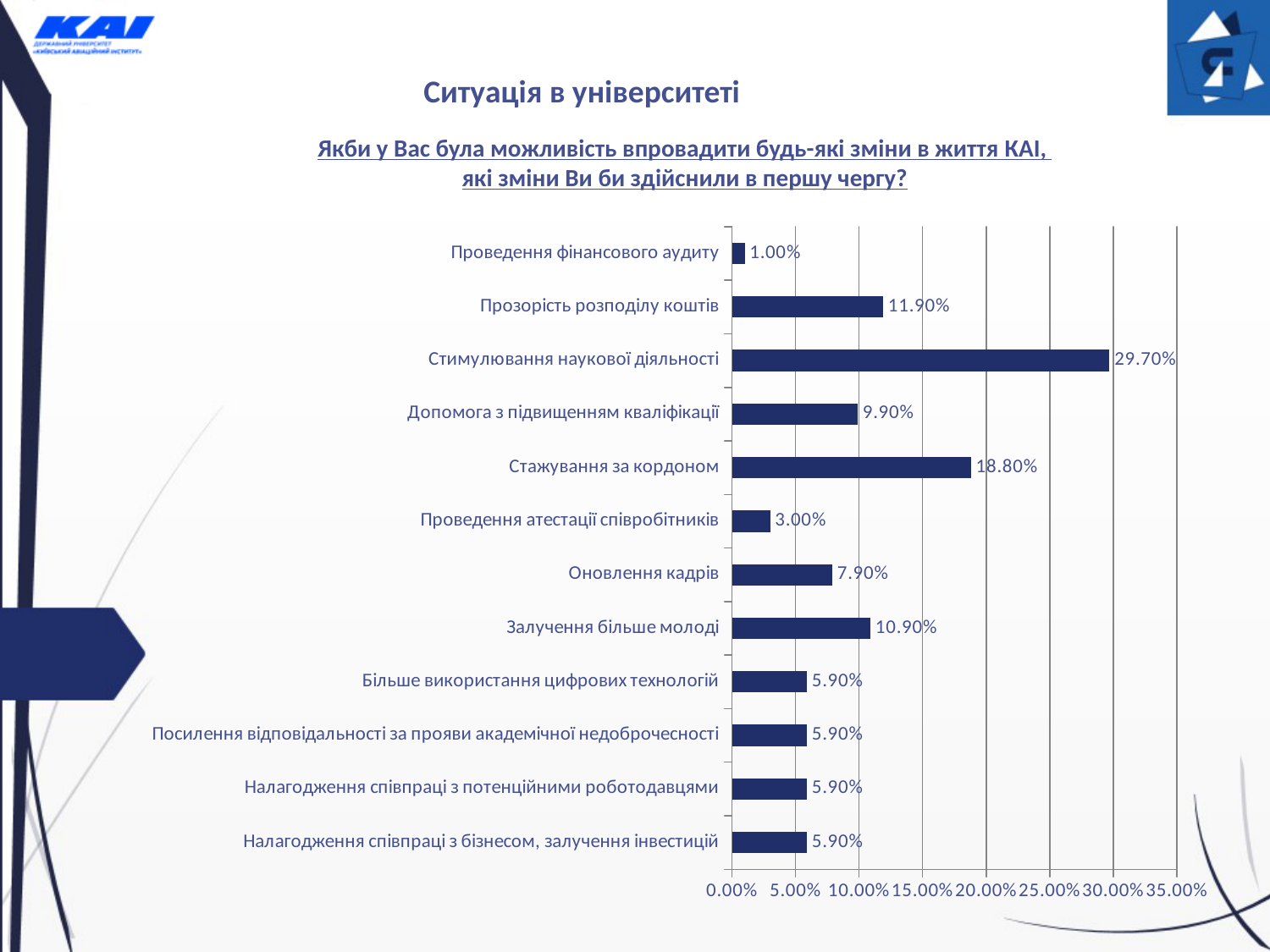
How many categories are shown in the chart? 12 Which is larger: the value for "Прозорість розподілу коштів" or the value for "Залучення більше молоді"? Прозорість розподілу коштів What is the difference between the values for "Стимулювання наукової діяльності" and "Стажування за кордоном"? 10.90% What value is shown for "Стимулювання наукової діяльності"? 29.70% What value is shown for "Оновлення кадрів"? 7.90% What value is shown for "Стажування за кордоном"? 18.80% What kind of chart is shown on the slide? bar chart How many categories share the value 5.90%? 4 Is the value for "Стажування за кордоном" greater or less than 15.00%? greater Which category has the lowest value? Проведення фінансового аудиту Which category has the highest value? Стимулювання наукової діяльності What value is shown for "Проведення фінансового аудиту"? 1.00%